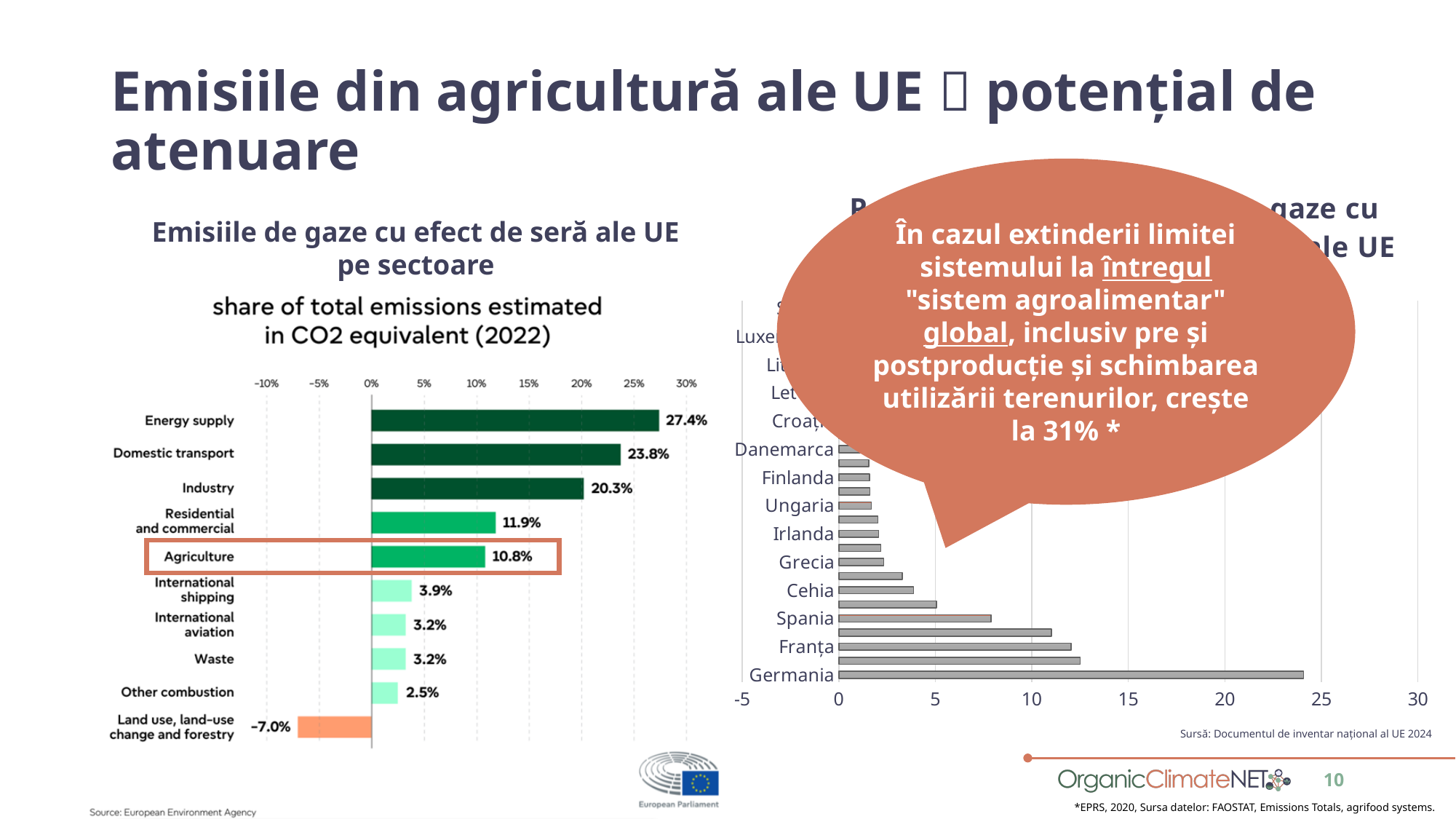
On the left chart (Emisiile de gaze cu efect de seră ale UE pe sectoare), what is the difference between Domestic transport and Industry? 3.5% On the left chart (Emisiile de gaze cu efect de seră ale UE pe sectoare), what is the value for Land use, land-use change and forestry? -7.0% On the left chart (Emisiile de gaze cu efect de seră ale UE pe sectoare), what is the value for Agriculture? 10.8% On the right chart (the country bar chart), is the value for Germania greater or less than 20? greater On the left chart (Emisiile de gaze cu efect de seră ale UE pe sectoare), how many sectors are plotted? 10 What kind of chart is the left chart (Emisiile de gaze cu efect de seră ale UE pe sectoare)? Bar chart On the left chart (Emisiile de gaze cu efect de seră ale UE pe sectoare), which sector has the highest share? Energy supply On the left chart (Emisiile de gaze cu efect de seră ale UE pe sectoare), what is the value for Energy supply? 27.4% On the left chart (Emisiile de gaze cu efect de seră ale UE pe sectoare), which is larger: Residential and commercial or Agriculture? Residential and commercial On the left chart, what year is given in the subtitle for the estimated share of total emissions? 2022 On the right chart (the country bar chart), which is larger: Franța or Cehia? Franța On the left chart (Emisiile de gaze cu efect de seră ale UE pe sectoare), which sector has the lowest value? Land use, land-use change and forestry